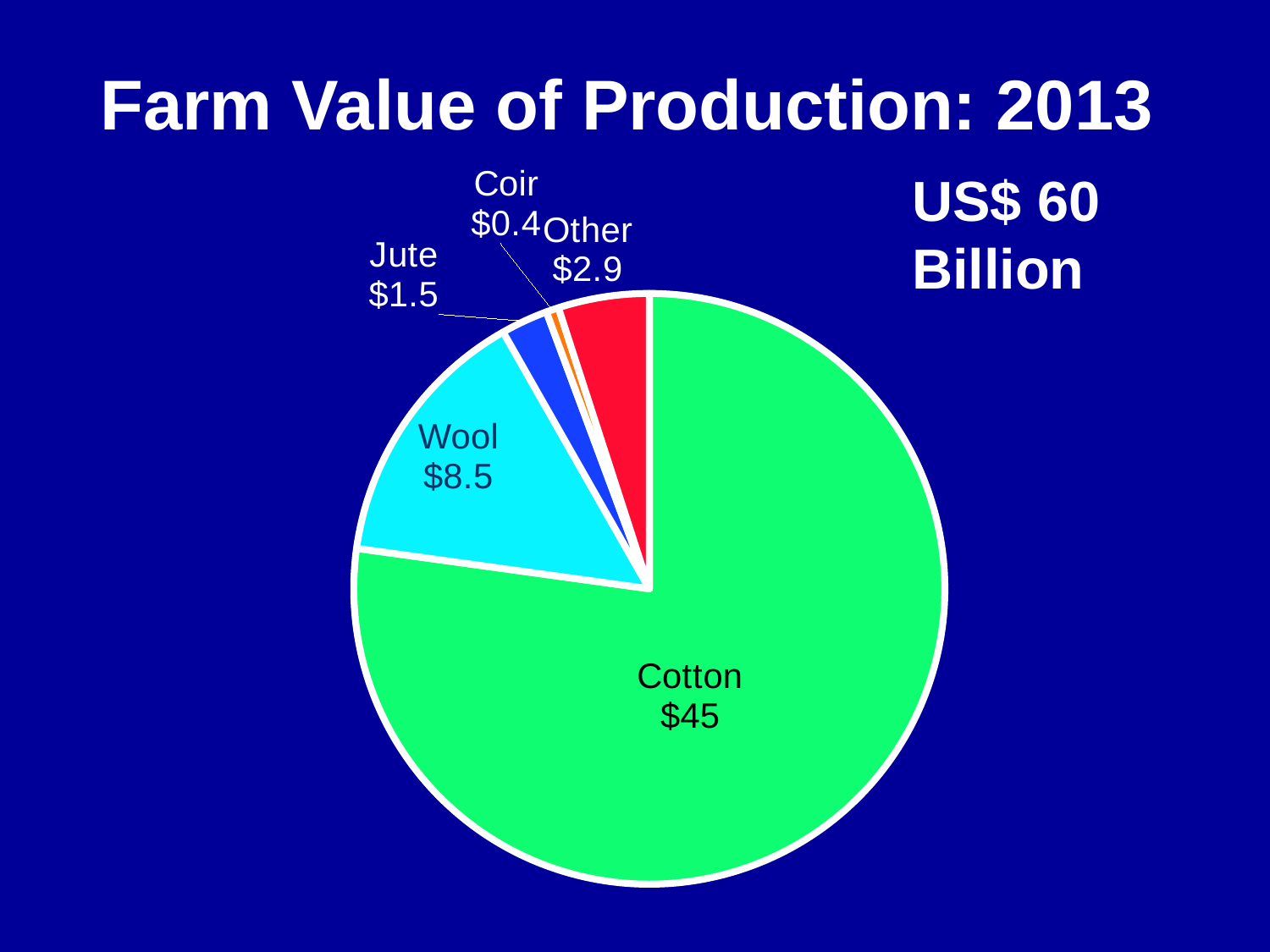
How many slices does the pie chart have? 5 What is the title of the chart on the slide? Farm Value of Production: 2013 Which category has the largest slice of the pie? Cotton Which is larger, the value for Wool or the value for Other? Wool What is the difference between the values for Cotton and Wool? $36.5 What kind of chart is shown on the slide? pie chart What is the farm value of production for Cotton? $45 What is the farm value of production for Coir? $0.4 What is the farm value of production for Wool? $8.5 Which category has the smallest slice of the pie? Coir What is the farm value of production for Other? $2.9 What is the farm value of production for Jute? $1.5